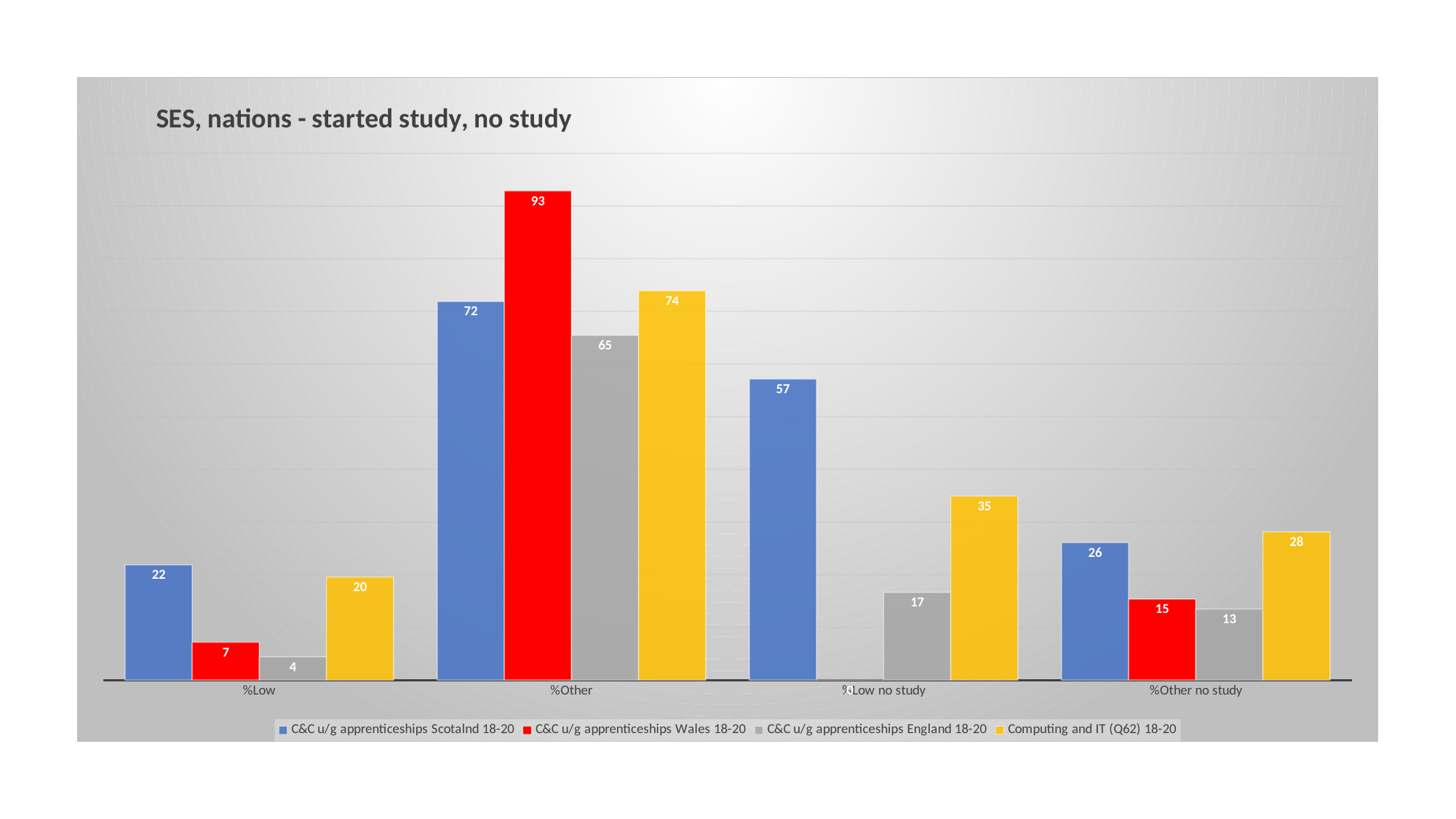
What is the difference between the Wales 18-20 and Scotalnd 18-20 values in the %Other category? 21 What is the value for C&C u/g apprenticeships England 18-20 in the %Low category? 4 What is the value for Computing and IT (Q62) 18-20 in the %Low no study category? 35 How many categories are shown on the x axis? 4 What is the value for C&C u/g apprenticeships Wales 18-20 in the %Other category? 93 How many series does the legend list? 4 What kind of chart is shown on the slide? Bar chart Which series has the lowest value in the %Low category? C&C u/g apprenticeships England 18-20 What is the value for C&C u/g apprenticeships Scotalnd 18-20 in the %Other no study category? 26 What is the title of the chart? SES, nations - started study, no study In the %Other no study category, which is larger: the Computing and IT (Q62) 18-20 value or the Scotalnd 18-20 value? Computing and IT (Q62) 18-20 Which series has the highest value in the %Other category? C&C u/g apprenticeships Wales 18-20